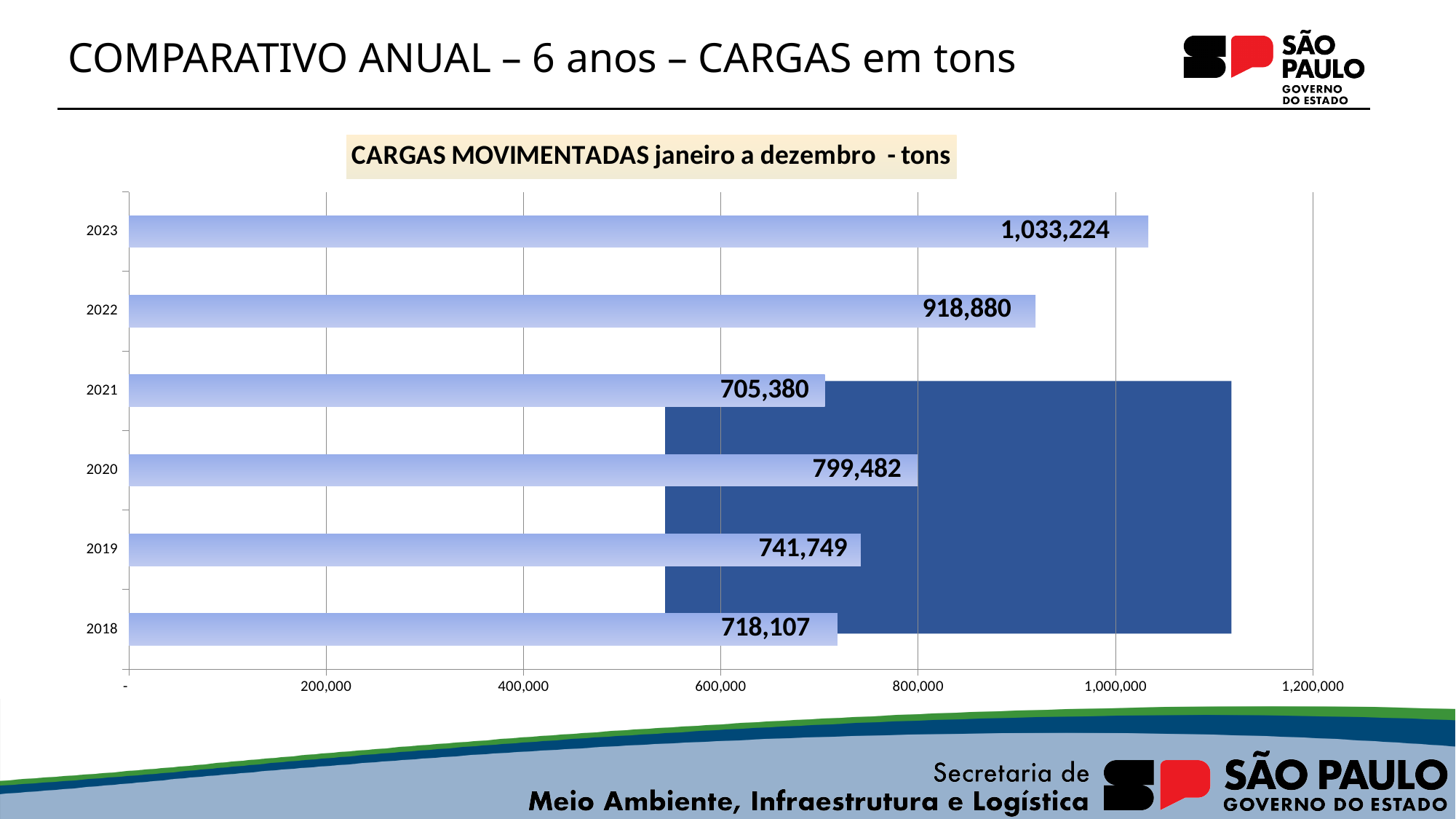
What is the title of the chart? CARGAS MOVIMENTADAS janeiro a dezembro - tons What is the difference between the values for 2019 and 2018? 23,642 How many years are shown in the chart? 6 Which is larger, the value for 2020 or the value for 2019? 2020 What is the value for 2020? 799,482 What is the difference between the values for 2023 and 2022? 114,344 What is the value for 2018? 718,107 What is the value for 2023? 1,033,224 Which year has the highest value? 2023 Is the value for 2022 greater or less than 800,000? greater What kind of chart is shown? bar chart Which year has the lowest value? 2021